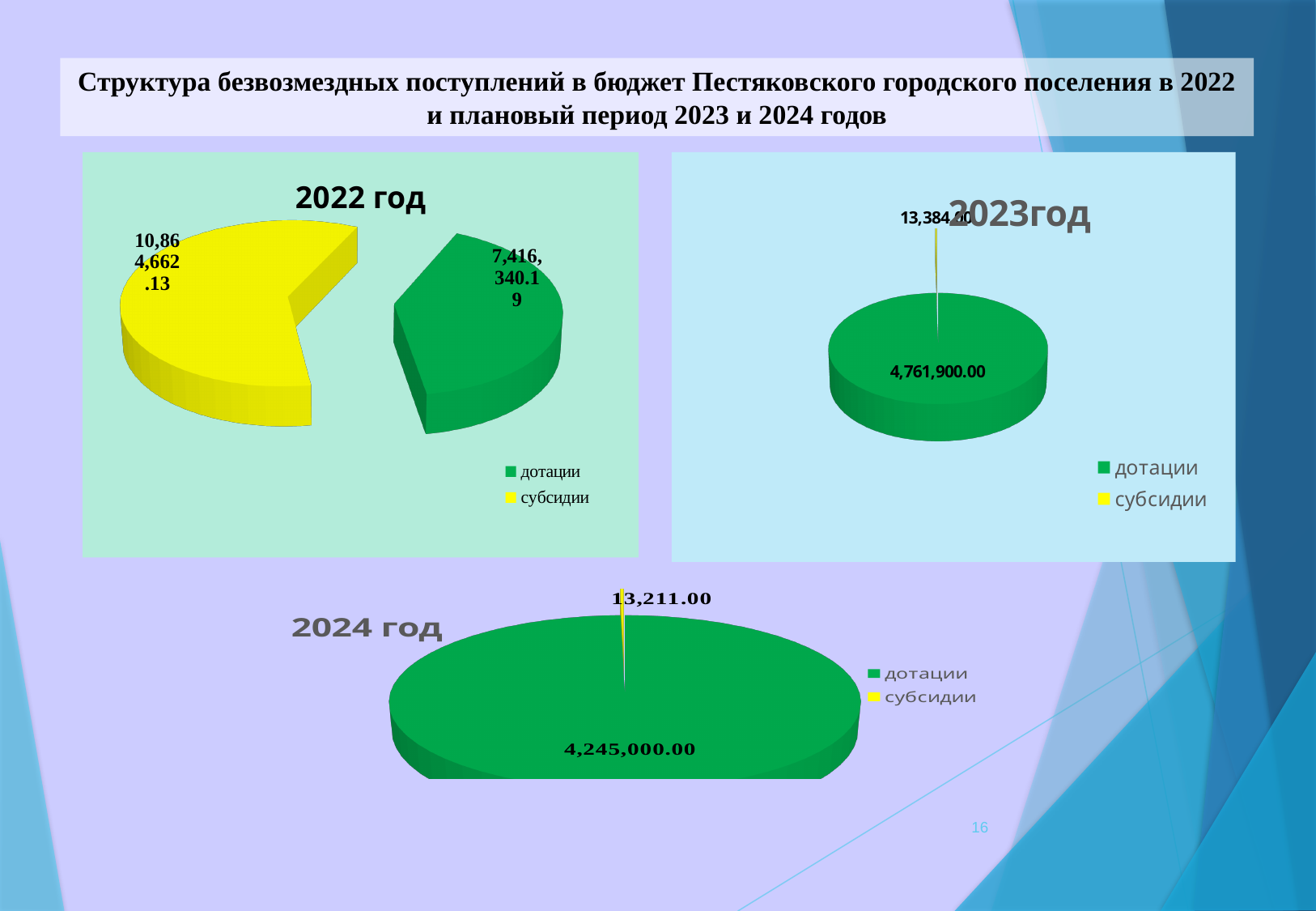
In the "2023год" chart, what is the value for дотации? 4,761,900.00 In the "2022 год" chart, what colour represents дотации? green In the "2022 год" chart, what is the difference between субсидии and дотации? 3,448,321.94 In the "2024 год" chart, what is the value for субсидии? 13,211.00 In the "2024 год" chart, what is the value for дотации? 4,245,000.00 In the "2022 год" chart, which category has the larger slice? субсидии How many categories does the legend of the "2024 год" chart list? 2 In the "2022 год" chart, what is the value for дотации? 7,416,340.19 In the "2024 год" chart, what is the difference between дотации and субсидии? 4,231,789.00 In the "2022 год" chart, what is the value for субсидии? 10,864,662.13 What kind of chart is the "2022 год" chart? pie chart In the "2023год" chart, which is larger, дотации or субсидии? дотации